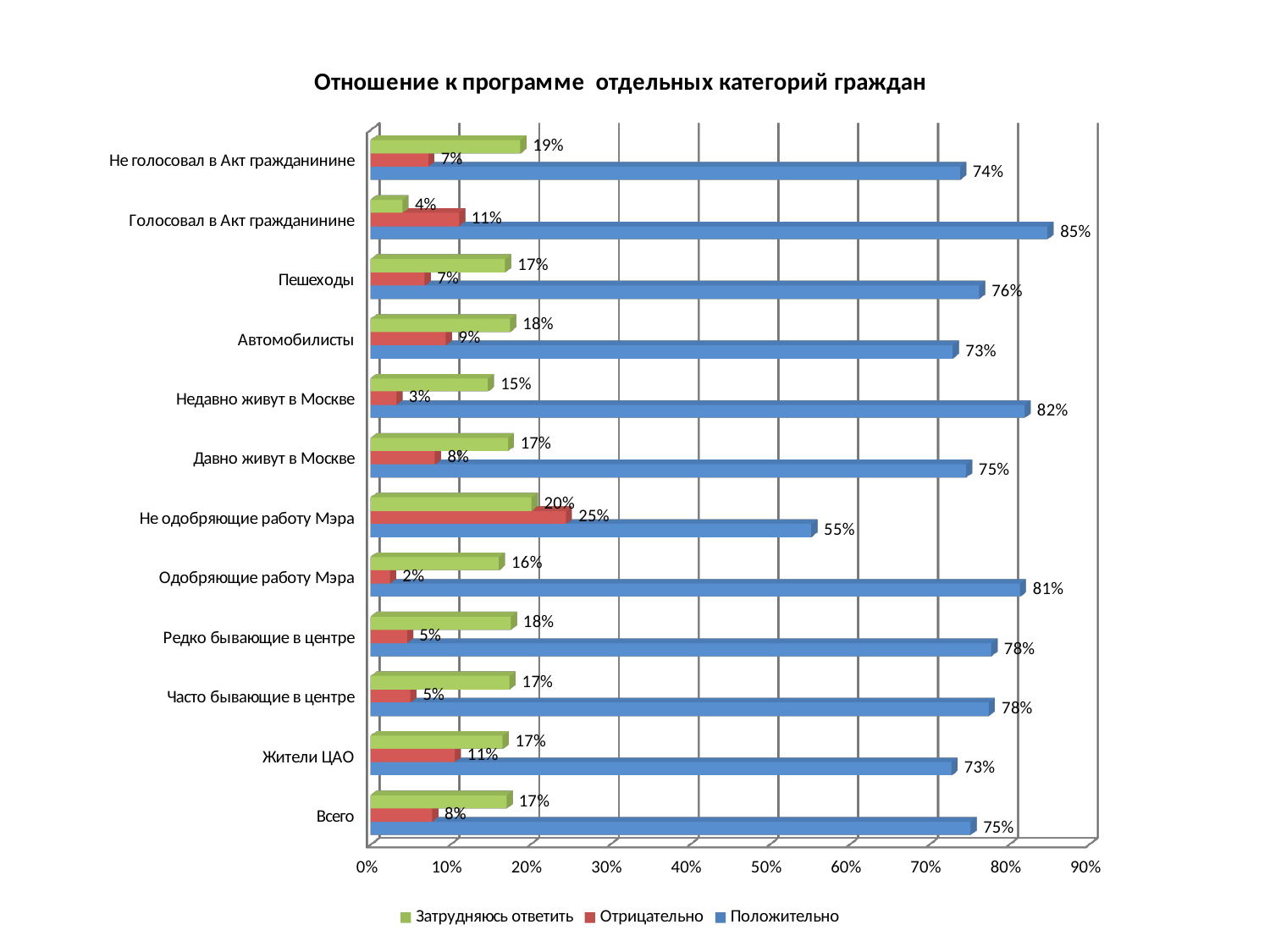
What type of chart is shown on the slide? Bar chart How many categories are shown on the chart? 12 What is the value of Отрицательно for Не одобряющие работу Мэра? 25% What is the difference between the Положительно values for Недавно живут в Москве and Давно живут в Москве? 7% What is the value of Положительно for Голосовал в Акт гражданинине? 85% What is the title of the chart? Отношение к программе отдельных категорий граждан Which category has the lowest Отрицательно value? Одобряющие работу Мэра Which category has the highest Положительно value? Голосовал в Акт гражданинине Which is larger: the Отрицательно value for Жители ЦАО or for Автомобилисты? Жители ЦАО How many series does the legend list? 3 Which category has the lowest Положительно value? Не одобряющие работу Мэра What is the value of Затрудняюсь ответить for Всего? 17%